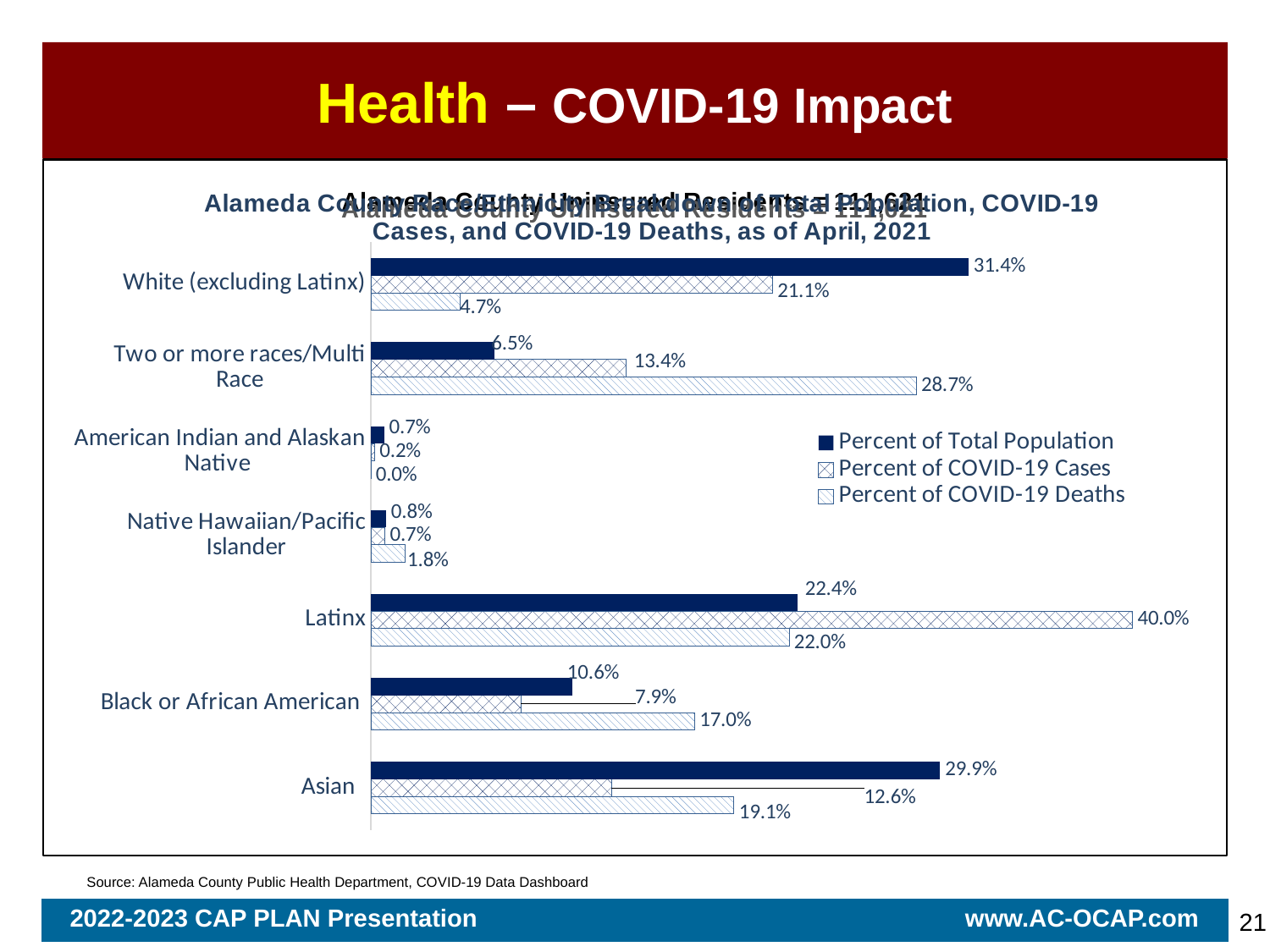
What is the Percent of Total Population for Asian? 29.9% How many series does the legend list? 3 What is the difference between the Percent of COVID-19 Cases and the Percent of Total Population for Latinx? 17.6% What is the Percent of COVID-19 Cases for Latinx? 40.0% Which category has the lowest Percent of COVID-19 Deaths? American Indian and Alaskan Native Which series is shown with solid dark blue bars in the legend? Percent of Total Population For Black or African American, which is larger: Percent of COVID-19 Deaths or Percent of COVID-19 Cases? Percent of COVID-19 Deaths How many racial/ethnic categories are plotted on the chart? 7 Which category has the highest Percent of Total Population? White (excluding Latinx) What type of chart is shown on the slide? bar chart What is the Percent of COVID-19 Deaths for Two or more races/Multi Race? 28.7% What is the difference between the Percent of Total Population and the Percent of COVID-19 Deaths for White (excluding Latinx)? 26.7%